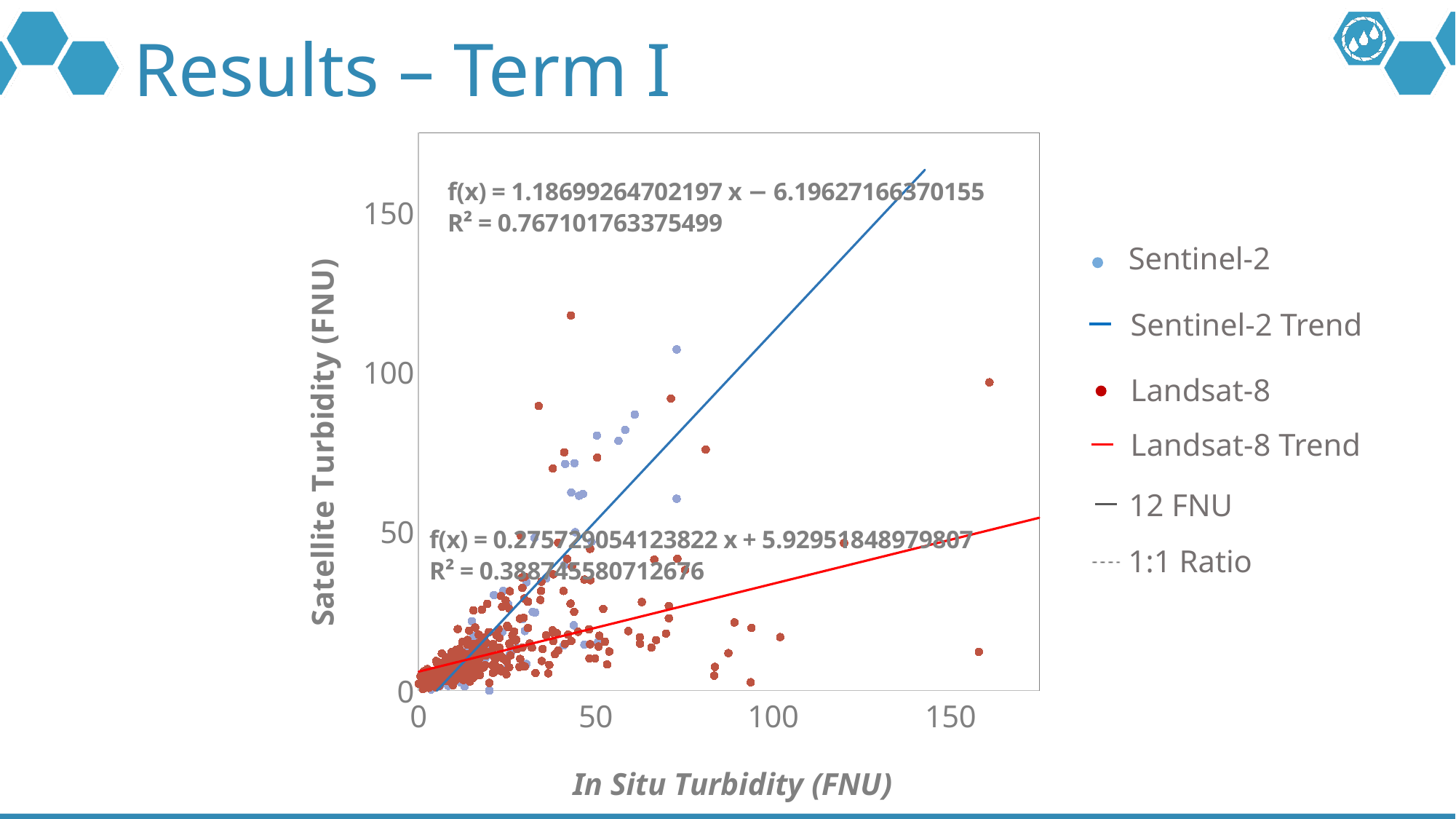
How many entries does the chart legend list? 6 What is the slope printed in the Sentinel-2 trend equation? 1.18699264702197 Does the Landsat-8 trend line rise or fall as In Situ Turbidity increases? Rise Which trend line has the higher R² value, Sentinel-2 or Landsat-8? Sentinel-2 Which trend line is steeper, Sentinel-2 Trend or Landsat-8 Trend? Sentinel-2 Trend What is the title of the x axis? In Situ Turbidity (FNU) What is the intercept printed in the Sentinel-2 trend equation? −6.19627166370155 What is the title of the y axis? Satellite Turbidity (FNU) What is the slope printed in the Landsat-8 trend equation? 0.275729054123822 What R² value is printed for the Sentinel-2 trend line? 0.767101763375499 What kind of chart is shown on the slide? Scatter chart